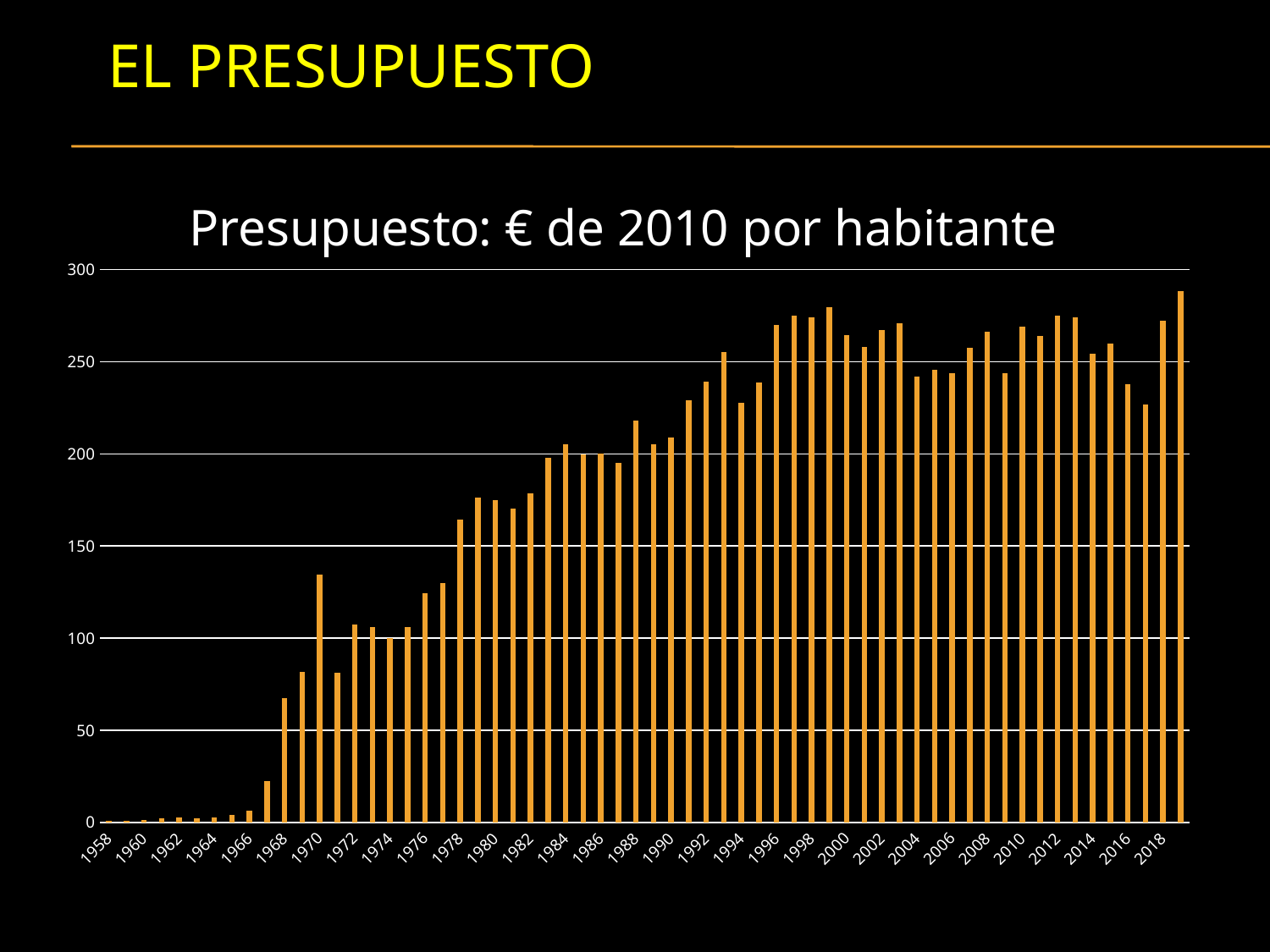
Is the value for 2016 greater or less than 250? less What is the title of the chart? Presupuesto: € de 2010 por habitante What colour are the bars in the chart? orange Is the value for 1996 greater or less than 250? greater Do the values generally rise or fall from 1958 to 1970? rise Is the value for 1970 greater or less than 100? greater Which year has the larger value, 1970 or 1971? 1970 Which year has the larger value, 1990 or 2000? 2000 Which year has the highest value in the chart? 2019 What kind of chart is shown on the slide? bar chart